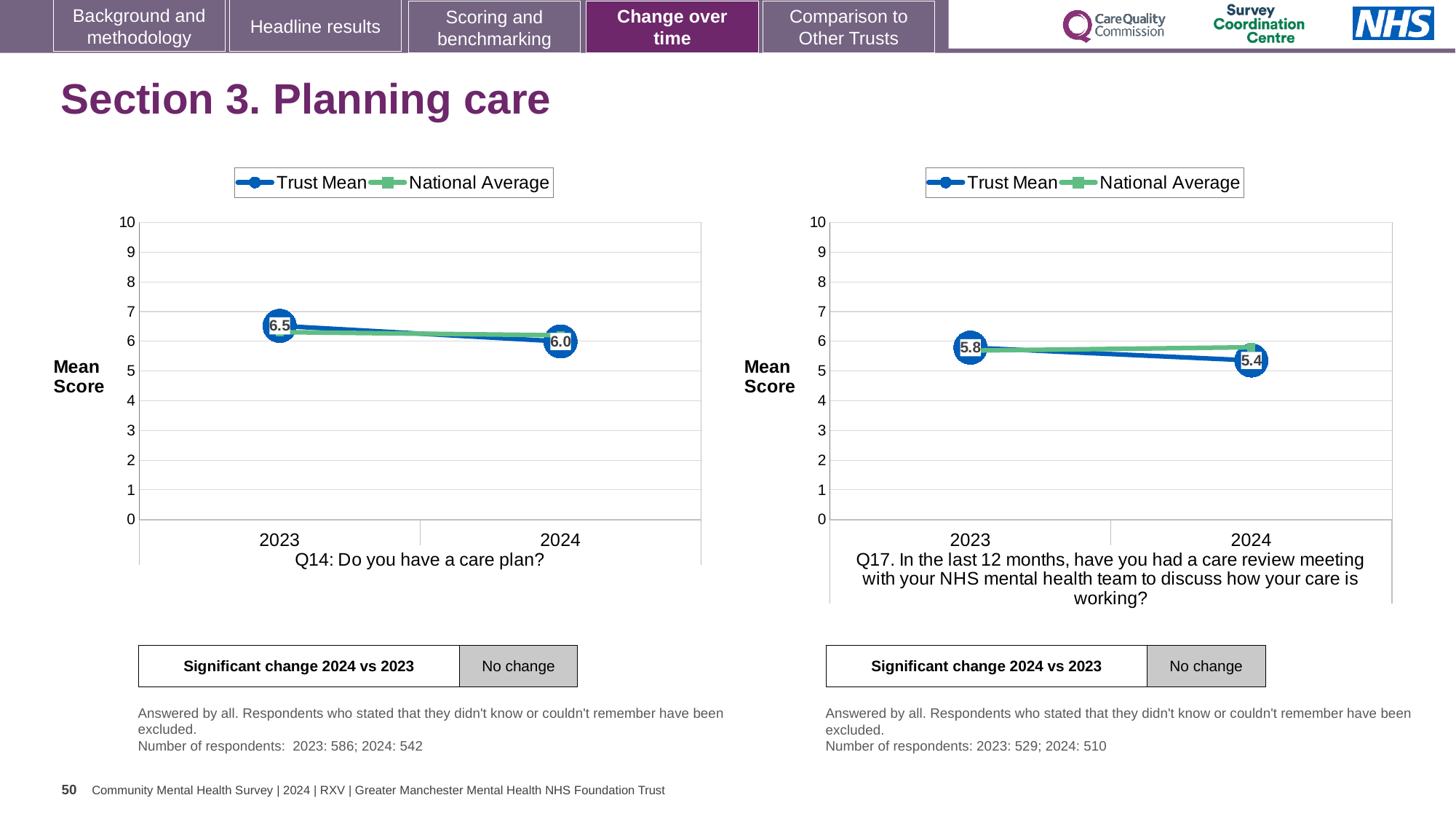
On the Q14 chart (left), by how much did the Trust Mean change from 2023 to 2024? 0.5 On the Q17 chart (right), does the Trust Mean rise or fall from 2023 to 2024? fall On the Q17 chart (right), what is the difference between the Trust Mean in 2023 and in 2024? 0.4 On the Q17 chart (right), what is the Trust Mean score for 2023? 5.8 How many series does the legend of the Q17 chart (right) list? 2 On the Q14 chart (left), what is the Trust Mean score for 2023? 6.5 On the Q17 chart (right), what is the Trust Mean score for 2024? 5.4 How many years are plotted on the x axis of the Q14 chart (left)? 2 On the Q14 chart (left), which year has the higher Trust Mean, 2023 or 2024? 2023 On the Q17 chart (right), is the National Average value for 2024 greater or less than 5? greater On the Q14 chart (left), what is the Trust Mean score for 2024? 6.0 What kind of chart is the Q14 chart on the left? line chart